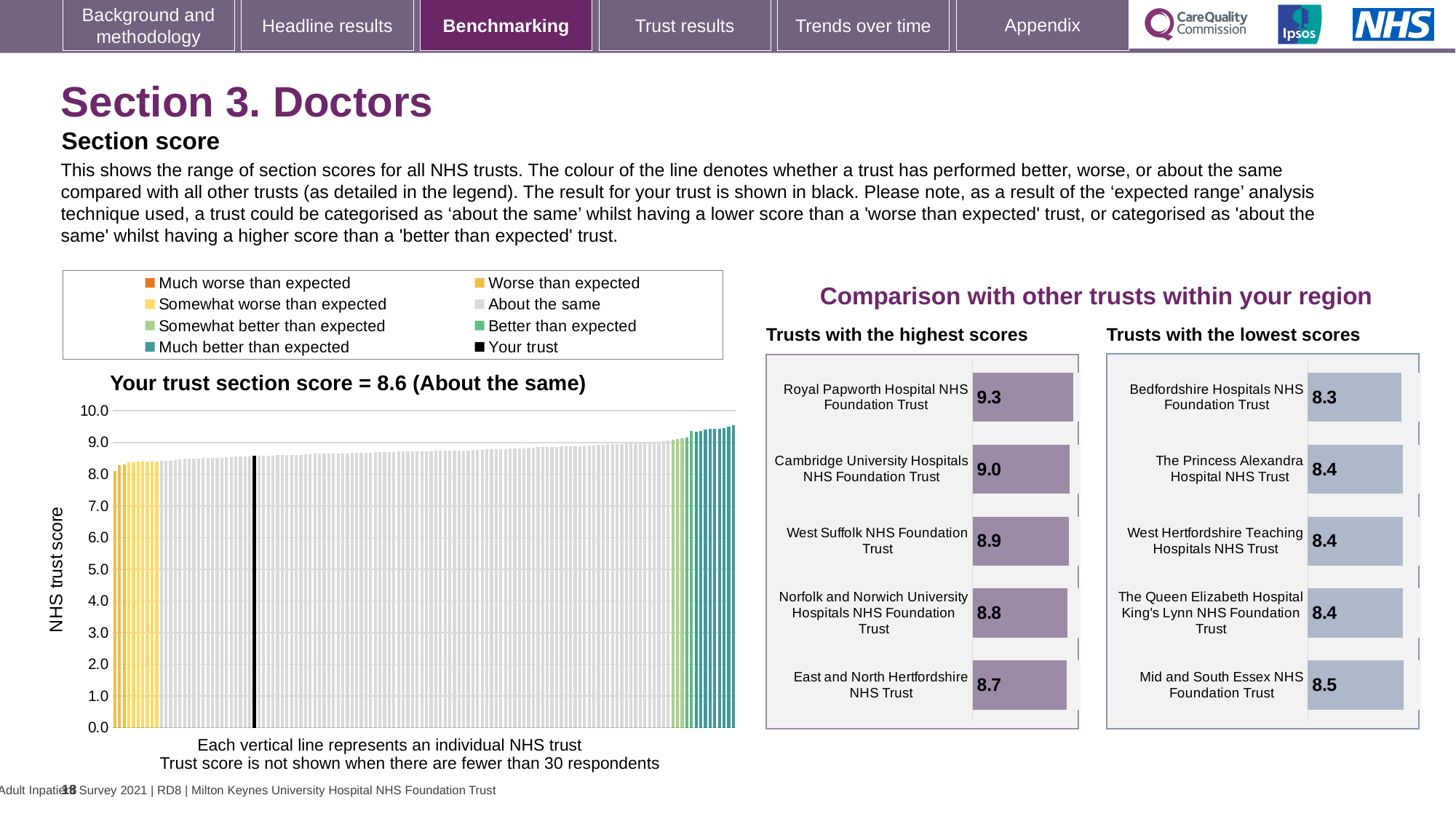
What kind of chart is the 'Your trust section score' chart? bar chart In the 'Trusts with the lowest scores' chart, what is the score for Bedfordshire Hospitals NHS Foundation Trust? 8.3 In the 'Your trust section score' chart, is the value of the highest bar greater or less than 9.0? greater How many trusts are shown in the 'Trusts with the highest scores' chart? 5 In the 'Trusts with the highest scores' chart, what is the difference between the scores of Royal Papworth Hospital NHS Foundation Trust and East and North Hertfordshire NHS Trust? 0.6 In the 'Trusts with the lowest scores' chart, which trust has the highest score? Mid and South Essex NHS Foundation Trust Which is larger: the score for Cambridge University Hospitals NHS Foundation Trust in the 'Trusts with the highest scores' chart or the score for Mid and South Essex NHS Foundation Trust in the 'Trusts with the lowest scores' chart? Cambridge University Hospitals NHS Foundation Trust In the 'Trusts with the highest scores' chart, what is the score for Royal Papworth Hospital NHS Foundation Trust? 9.3 How many entries does the legend above the 'Your trust section score' chart list? 8 In the 'Your trust section score' chart, what is the section score for your trust? 8.6 In the 'Trusts with the highest scores' chart, which trust has the lowest score? East and North Hertfordshire NHS Trust In the 'Your trust section score' chart, what is the label on the vertical axis? NHS trust score